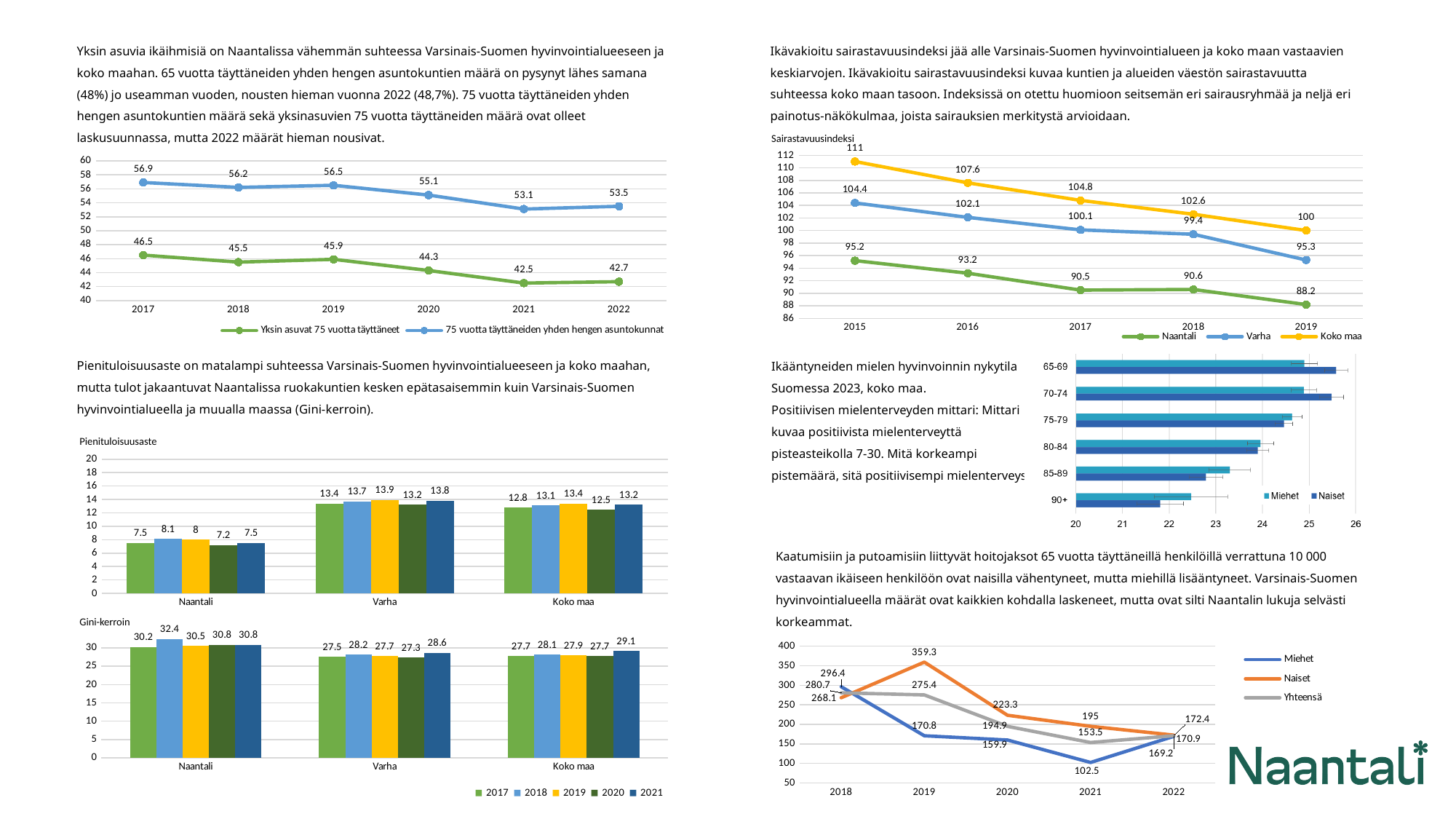
In the top-left line chart, which year has the lowest value for Yksin asuvat 75 vuotta täyttäneet? 2021 In the Pienituloisuusaste chart, which year has the highest value for Varha? 2019 In the bottom-right line chart, what is the difference between Miehet and Naiset in 2018? 28.3 In the Gini-kerroin chart, which year has the highest value for Naantali? 2018 In the horizontal bar chart of age groups (65-69 to 90+), is the value for Naiset in the 90+ group greater or less than 23? less In the Sairastavuusindeksi chart, how many series does the legend list? 3 In the Sairastavuusindeksi chart, what is the value for Koko maa in 2015? 111 In the Gini-kerroin chart, which is larger: Varha in 2021 or Koko maa in 2021? Koko maa in 2021 In the Sairastavuusindeksi chart, what is the difference between Varha and Naantali in 2019? 7.1 In the bottom-right line chart, what is the value for Naiset in 2019? 359.3 In the top-left line chart, what is the value for 75 vuotta täyttäneiden yhden hengen asuntokunnat in 2020? 55.1 In the Pienituloisuusaste chart, what is the value for Naantali in 2018? 8.1